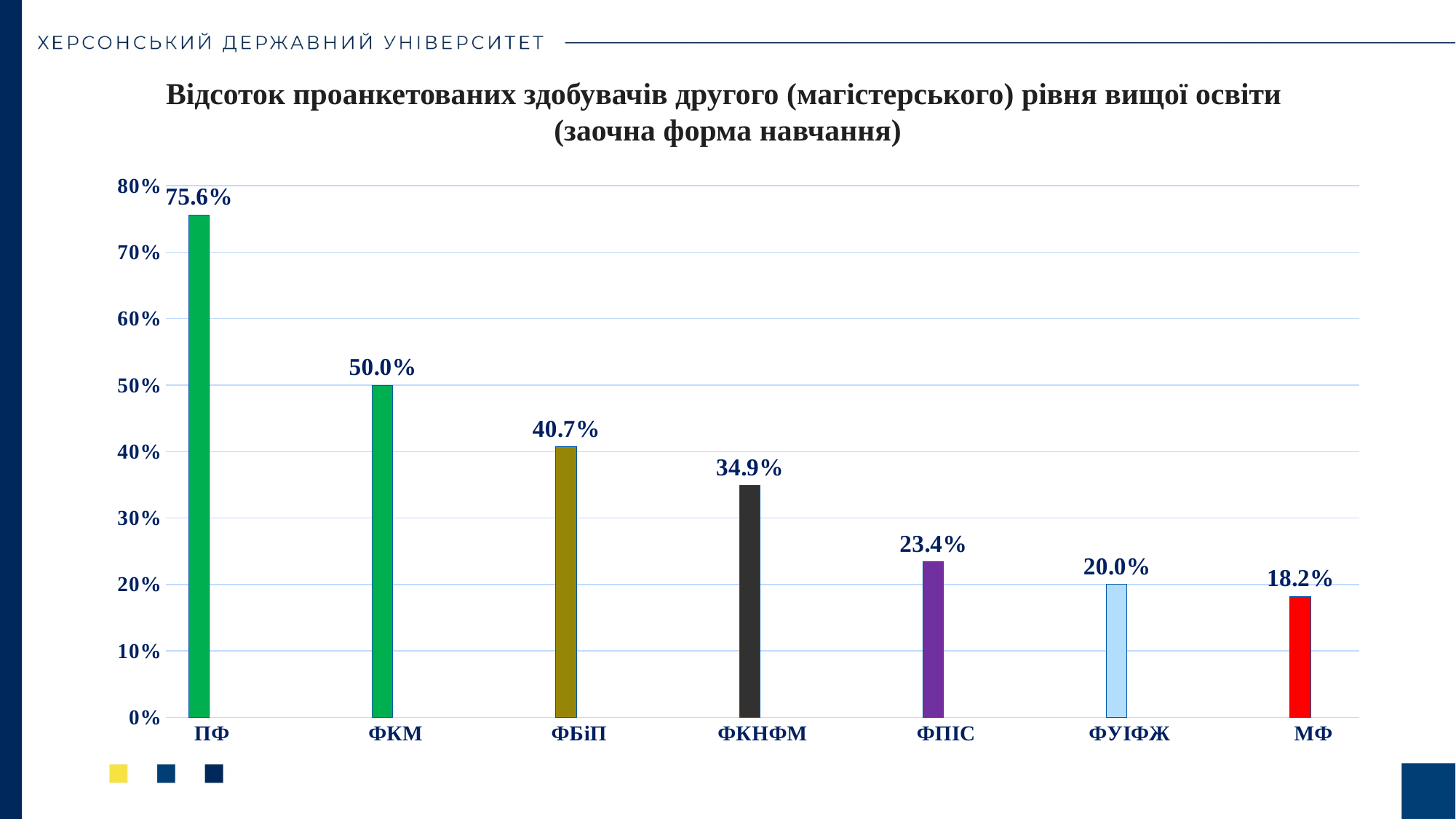
What is the value for ФУІФЖ? 20.0% Do the values rise or fall from left to right along the x axis? fall Which category has the highest value? ПФ What is the value for ПФ? 75.6% What kind of chart is shown on the slide? bar chart Is the value for ФБіП greater or less than 40%? greater What is the value for ФКНФМ? 34.9% Which category has the lowest value? МФ Which is larger, the value for ФПІС or the value for ФУІФЖ? ФПІС How many categories are shown on the x axis? 7 What is the difference between the values for ПФ and МФ? 57.4% What is the difference between the values for ФКМ and ФБіП? 9.3%